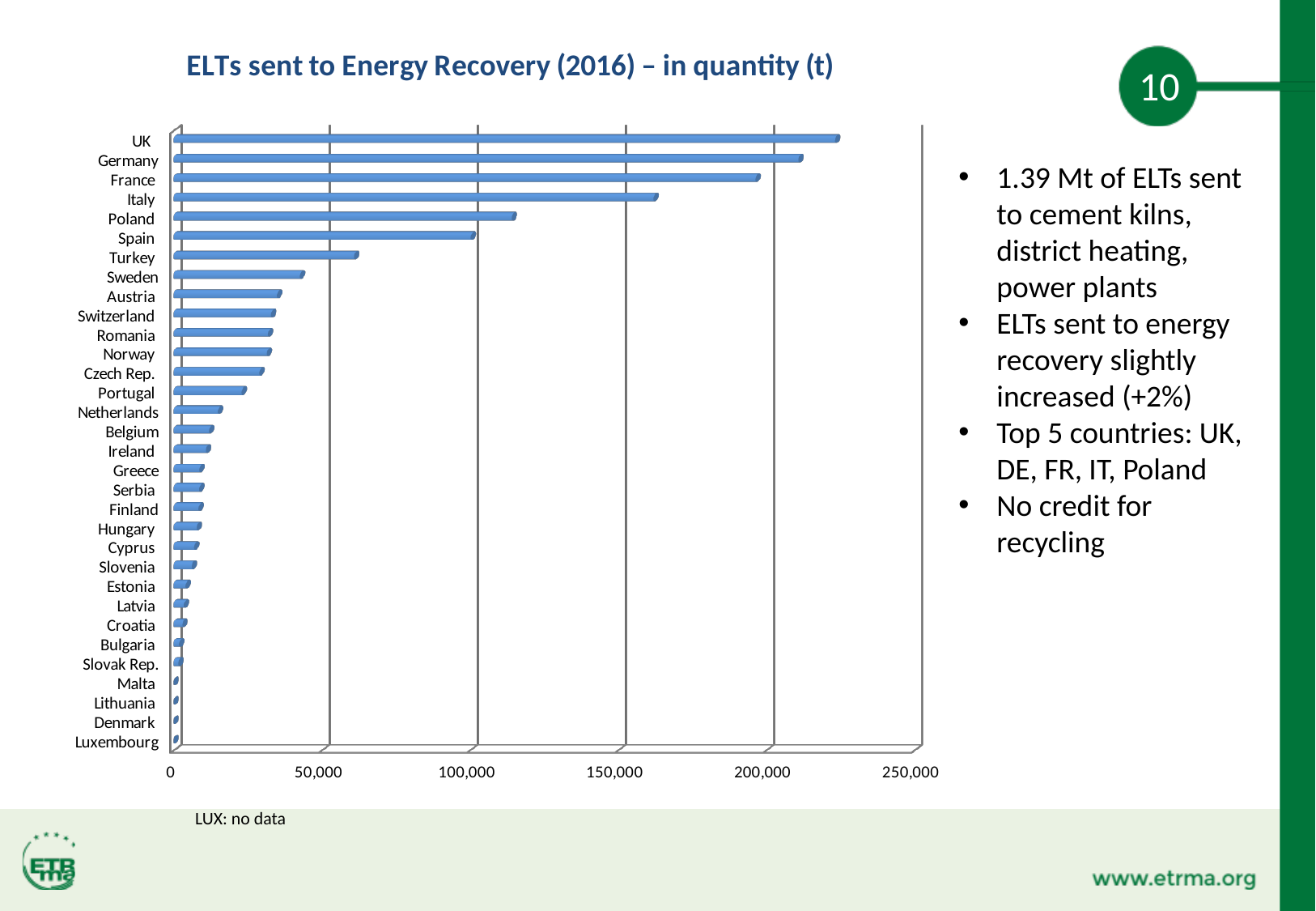
Which has a larger value, Germany or France? Germany Is the value for Sweden greater or less than 50,000? less What is the title of the chart? ELTs sent to Energy Recovery (2016) – in quantity (t) Do the bar values increase or decrease going from the top of the chart to the bottom? decrease Is the value for Italy greater or less than 150,000? greater Is the value for the UK greater or less than 200,000? greater Which country has the highest quantity of ELTs sent to energy recovery? UK How many countries are listed on the chart? 32 What kind of chart is shown on the slide? bar chart Which has a larger value, Italy or Poland? Italy